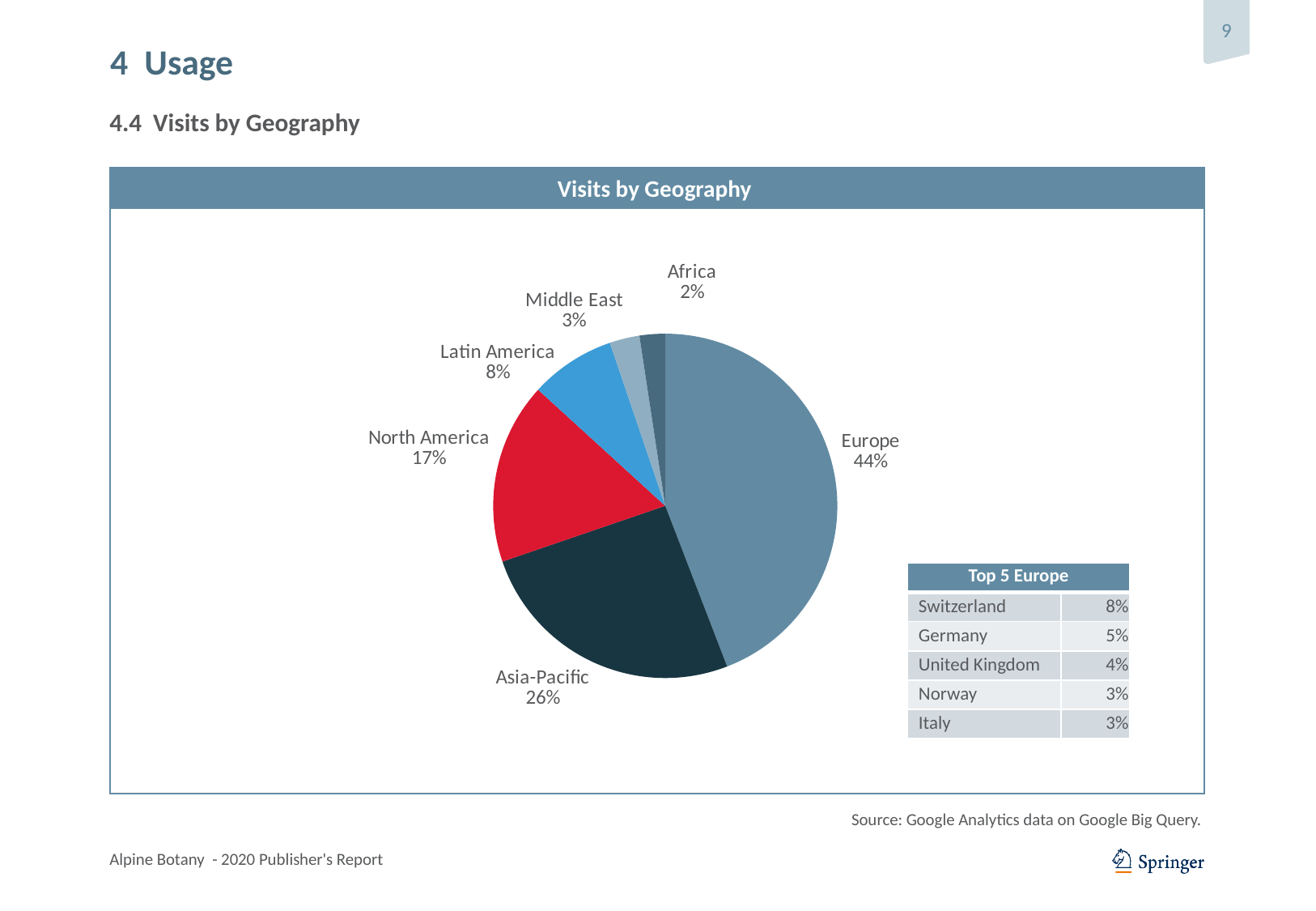
What is the value shown for North America? 17% What type of chart is used to show Visits by Geography? Pie chart What percentage of visits comes from Asia-Pacific? 26% What is the combined share of Middle East and Africa? 5% What share of visits does Europe account for in the Visits by Geography pie chart? 44% Which region has the smallest share of visits? Africa Which has a larger share of visits, North America or Latin America? North America What is the difference in percentage points between Europe and Asia-Pacific? 18 How many regions are shown in the pie chart? 6 Which region has the largest share of visits? Europe What is the title of the chart? Visits by Geography What share of visits is attributed to Latin America? 8%